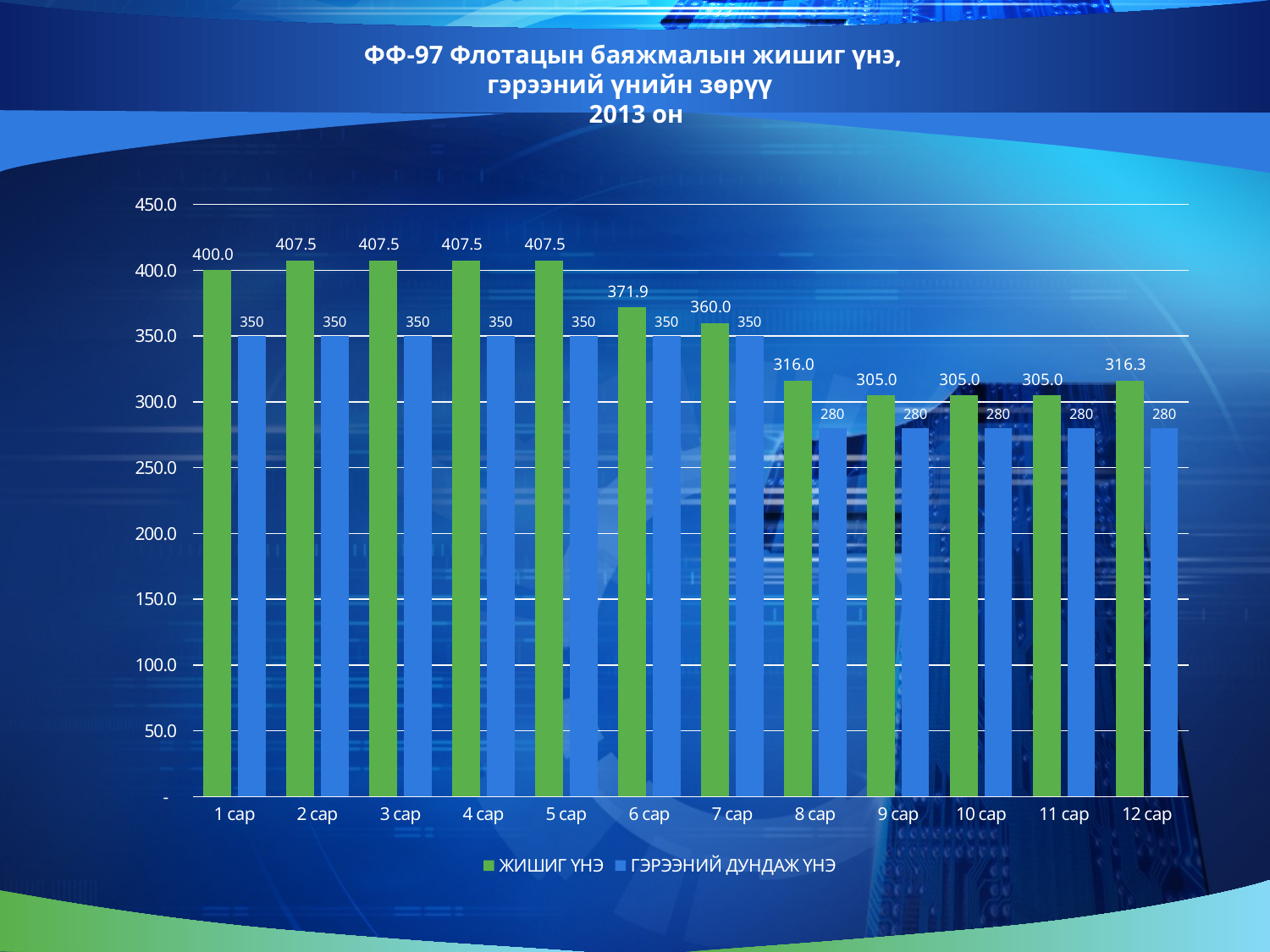
How many series does the legend list? 2 What is the difference between ЖИШИГ ҮНЭ for 12 сар and ЖИШИГ ҮНЭ for 11 сар? 11.3 How many months are shown on the x axis? 12 What is the value of ЖИШИГ ҮНЭ for 1 сар? 400.0 What is the highest value of ЖИШИГ ҮНЭ shown on the chart? 407.5 Which is larger for 8 сар: ЖИШИГ ҮНЭ or ГЭРЭЭНИЙ ДУНДАЖ ҮНЭ? ЖИШИГ ҮНЭ What is the difference between ЖИШИГ ҮНЭ and ГЭРЭЭНИЙ ДУНДАЖ ҮНЭ for 7 сар? 10.0 Which month has the lowest ЖИШИГ ҮНЭ value? 9 сар, 10 сар and 11 сар (305.0) What is the value of ГЭРЭЭНИЙ ДУНДАЖ ҮНЭ for 9 сар? 280 What is the value of ЖИШИГ ҮНЭ for 6 сар? 371.9 Does the ГЭРЭЭНИЙ ДУНДАЖ ҮНЭ series rise or fall from 1 сар to 12 сар? Fall What kind of chart is shown on the slide? Bar chart